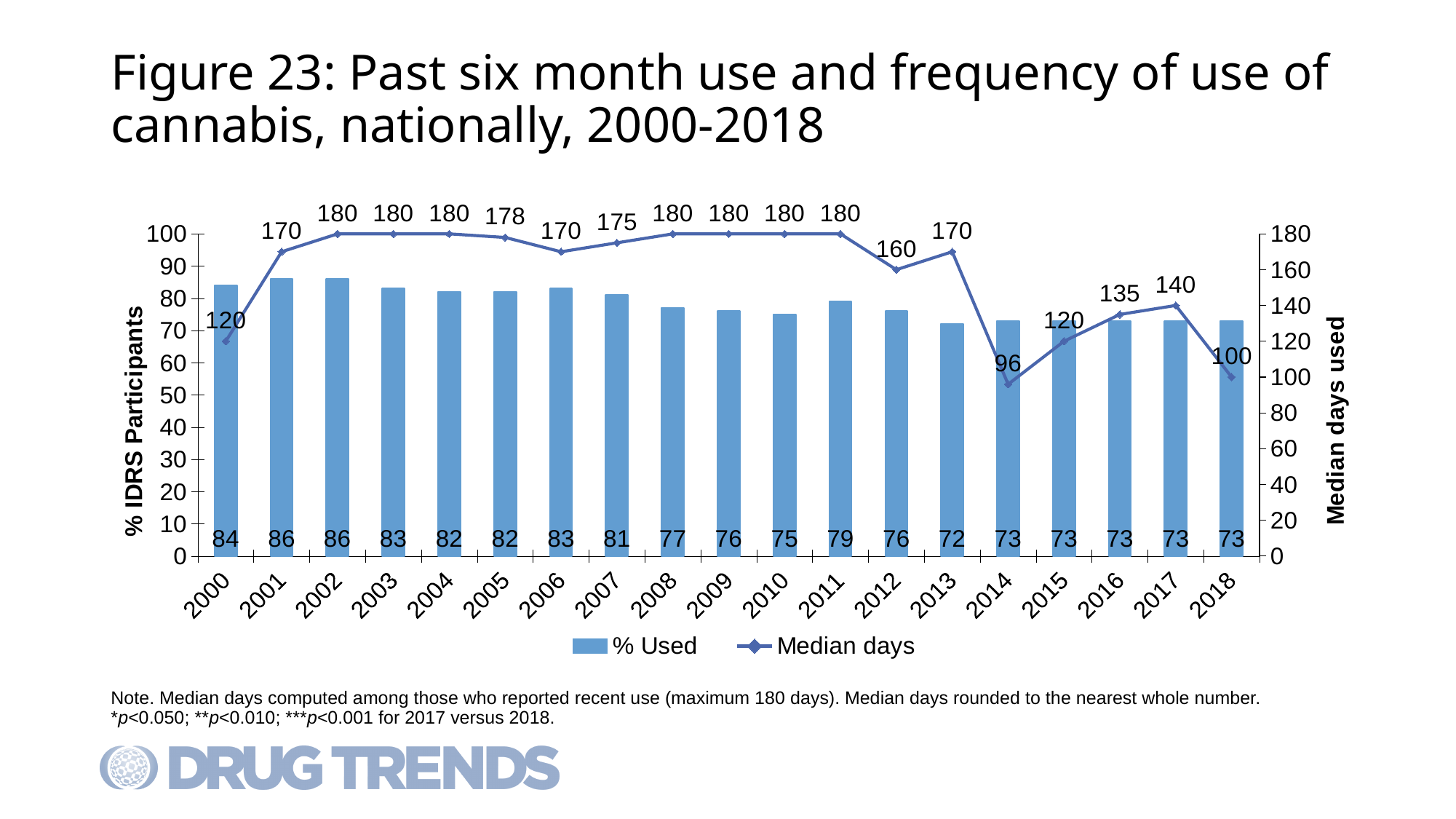
What was the Median days value in 2018? 100 What is the difference in Median days between 2013 and 2014? 74 What was the Median days value in 2014? 96 Which year had the lowest % Used value? 2013 What kind of chart is used to show the % Used series? Bar chart What is the difference in % Used between 2001 and 2018? 13 What was the % Used value in 2000? 84 How many series does the legend list? 2 What is the label of the right-hand vertical axis? Median days used Which year had the lowest Median days value? 2014 Which year had a higher Median days value, 2016 or 2017? 2017 How many years are shown on the x axis? 19